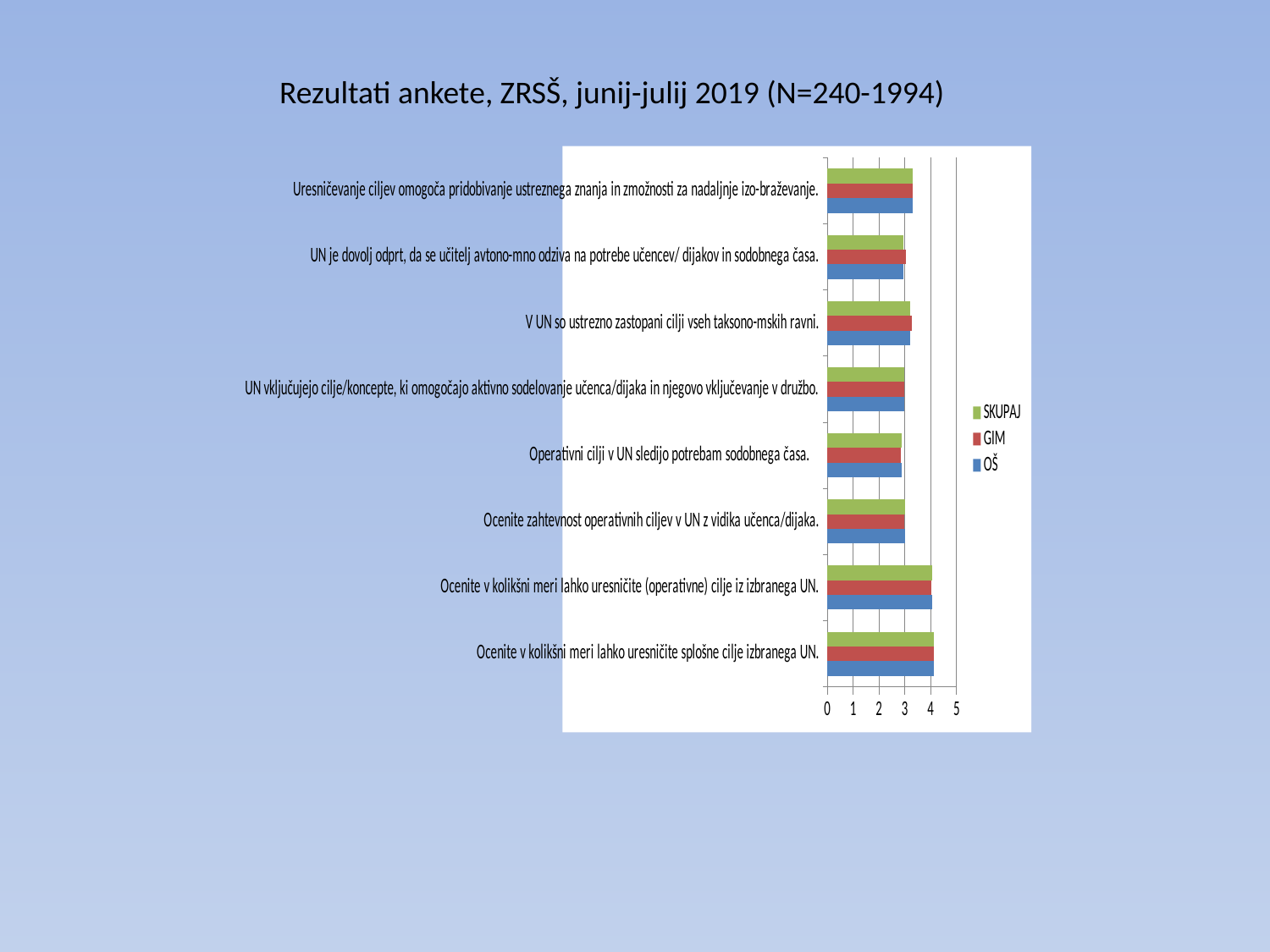
Is the SKUPAJ value for "Ocenite v kolikšni meri lahko uresničite splošne cilje izbranega UN." greater or less than 5? less What is the title of the slide containing the chart? Rezultati ankete, ZRSŠ, junij-julij 2019 (N=240-1994) What kind of chart is shown on the slide? bar chart What are the three series named in the legend? SKUPAJ, GIM, OŠ Is the GIM value for "Operativni cilji v UN sledijo potrebam sodobnega časa." greater or less than 2? greater How many categories (survey statements) are plotted on the chart? 8 Is the OŠ value for "V UN so ustrezno zastopani cilji vseh taksono-mskih ravni." greater or less than 3? greater How many series does the legend list? 3 Which is larger: the SKUPAJ value for "Ocenite v kolikšni meri lahko uresničite splošne cilje izbranega UN." or the SKUPAJ value for "Operativni cilji v UN sledijo potrebam sodobnega časa."? Ocenite v kolikšni meri lahko uresničite splošne cilje izbranega UN.